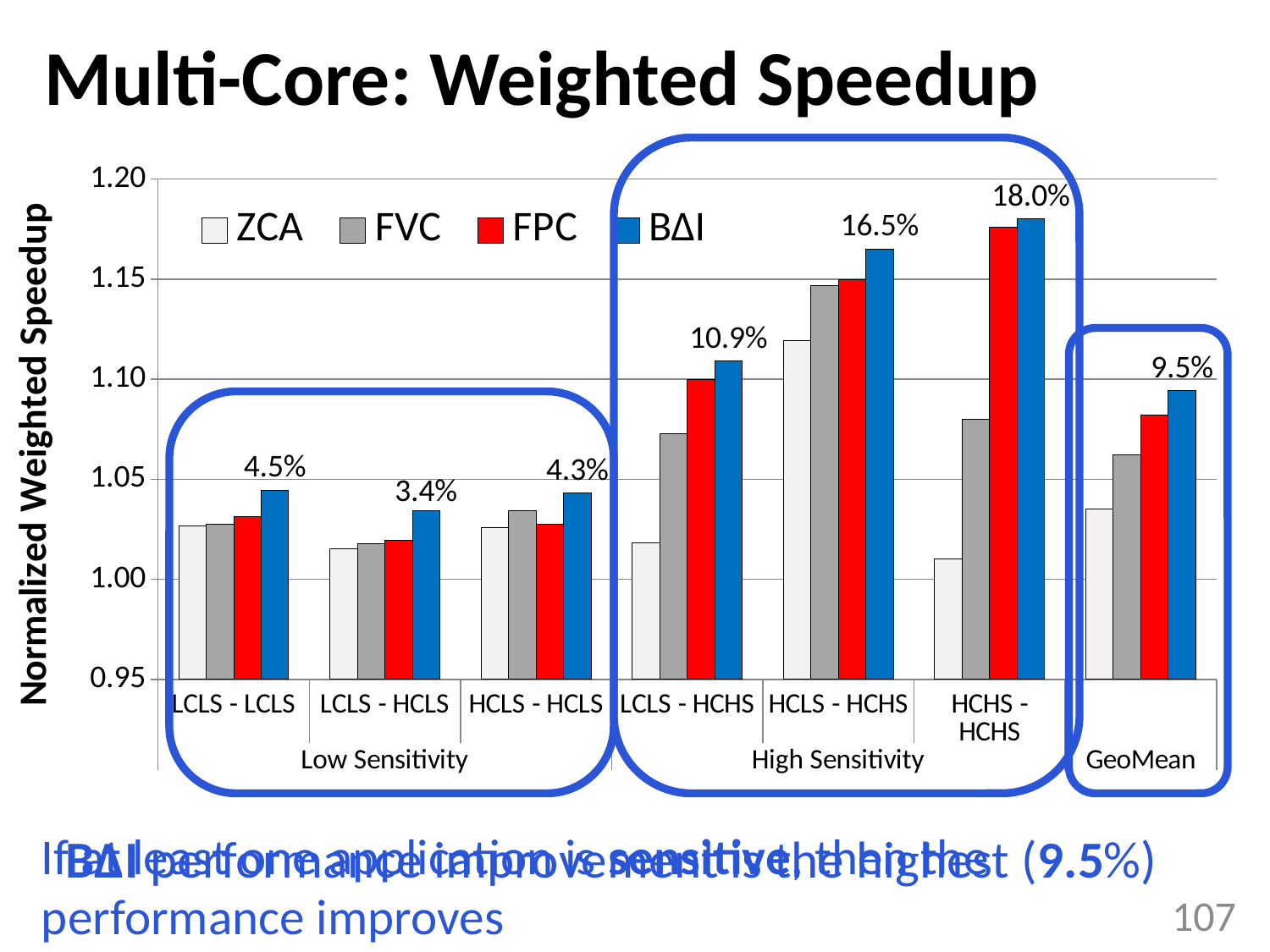
What percentage label is printed above the BΔI bar for GeoMean? 9.5% Which category has the highest BΔI bar? HCHS - HCHS Is the BΔI value for HCHS - HCHS greater or less than 1.15? greater Is the ZCA value for HCHS - HCHS greater or less than 1.05? less How many workload categories are shown along the x axis? 7 What is the title of the slide containing the chart? Multi-Core: Weighted Speedup What percentage label is printed above the BΔI bar for HCHS - HCHS? 18.0% How many series does the legend list? 4 For HCHS - HCHS, which is larger, the ZCA bar or the FVC bar? FVC What percentage label is printed above the BΔI bar for LCLS - HCLS? 3.4% Which category has the lowest BΔI bar? LCLS - HCLS What kind of chart is shown on the slide? bar chart